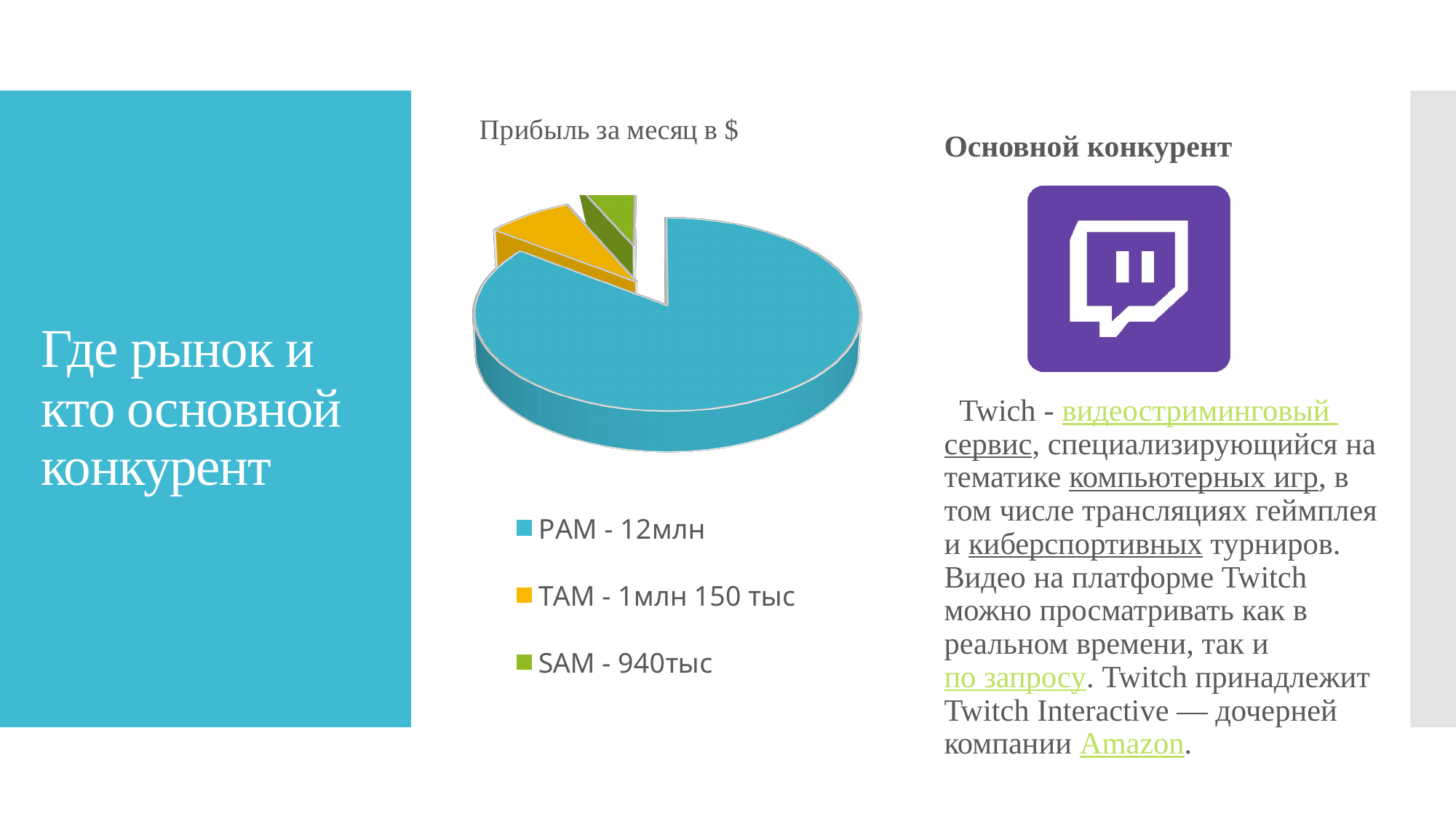
Which category has the largest slice of the pie? PAM Which category is shown in yellow in the pie chart? TAM How many entries does the chart legend list? 3 What value is given for PAM in the chart legend? 12млн What value is given for TAM in the chart legend? 1млн 150 тыс What value is given for SAM in the chart legend? 940тыс How many slices does the pie chart have? 3 What colour is the PAM slice in the pie chart? blue Which is larger, TAM or SAM? TAM What is the title of the chart? Прибыль за месяц в $ Which category has the smallest slice of the pie? SAM What kind of chart is shown on the slide? pie chart